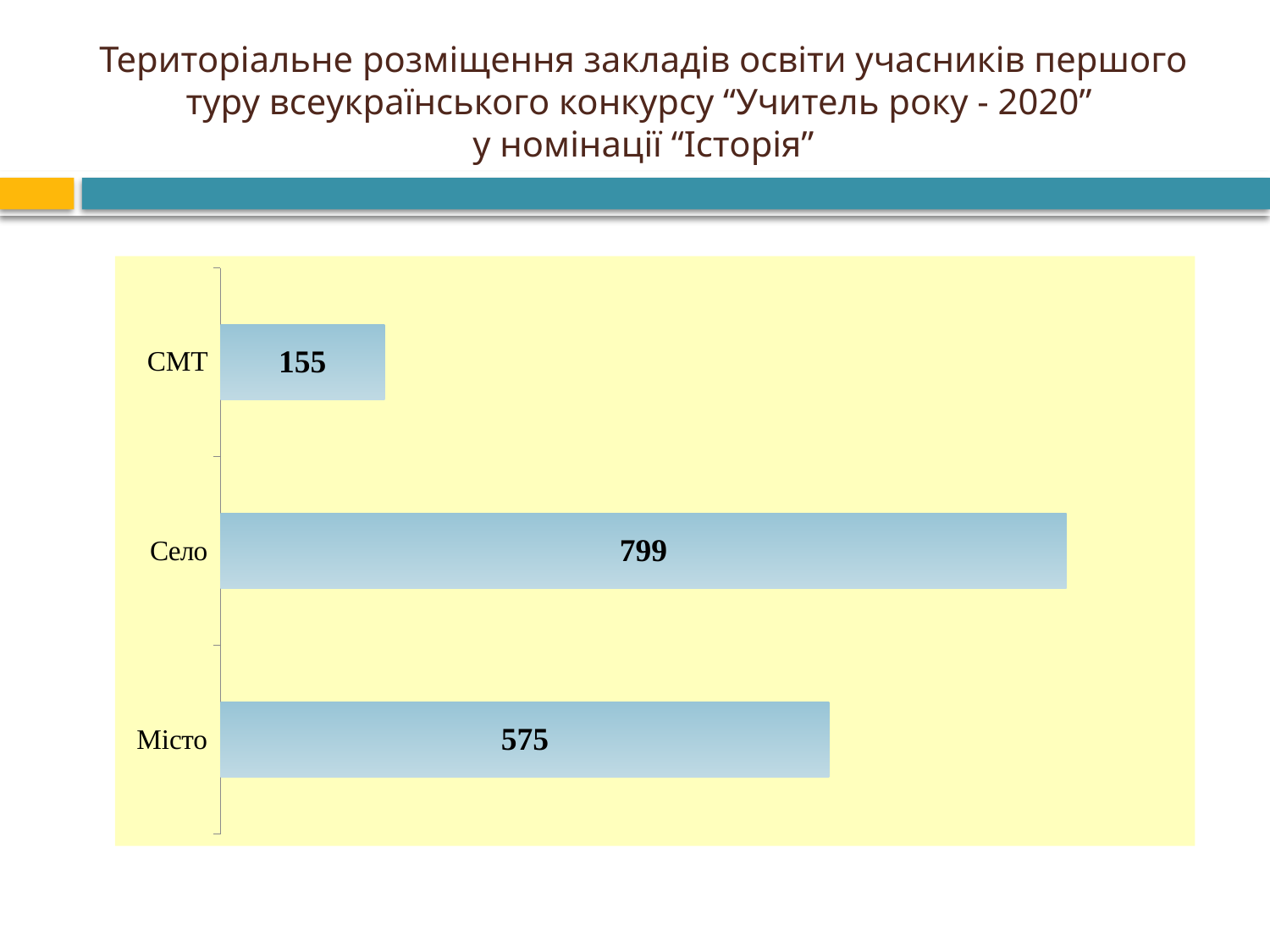
Which is larger, the value for Місто or the value for СМТ? Місто What is the difference between the values for Місто and СМТ? 420 What is the value for Село? 799 What kind of chart is shown on the slide? bar chart What is the total of the three values shown in the chart? 1529 What is the background colour of the chart area? light yellow Which category has the highest value? Село Which category has the lowest value? СМТ What is the value for Місто? 575 What is the value for СМТ? 155 How many categories are shown in the chart? 3 What is the difference between the values for Село and Місто? 224